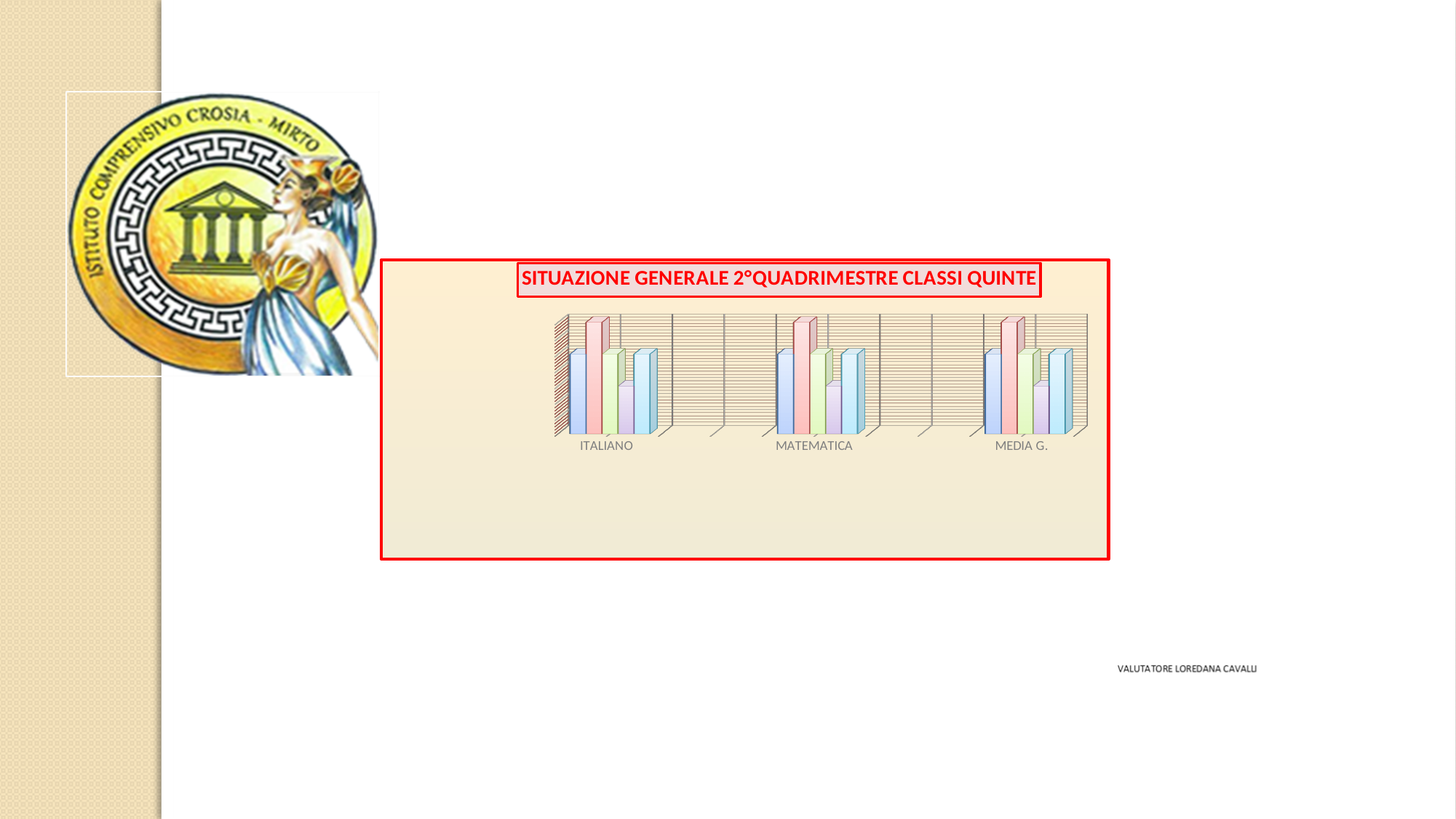
In the MEDIA G. group, which is taller, the pink bar or the blue bar? the pink bar In the ITALIANO group, which coloured bar is the tallest? the pink bar How many bars are plotted in each category group of the chart? 5 In the MATEMATICA group, which coloured bar is the shortest? the purple bar In the ITALIANO group, which is taller, the green bar or the purple bar? the green bar What kind of chart is shown on the slide? bar chart How many categories are shown on the x axis of the chart? 3 In the MEDIA G. group, which coloured bar is the shortest? the purple bar What is the title of the chart? SITUAZIONE GENERALE 2°QUADRIMESTRE CLASSI QUINTE What are the three category labels on the x axis of the chart? ITALIANO, MATEMATICA, MEDIA G.